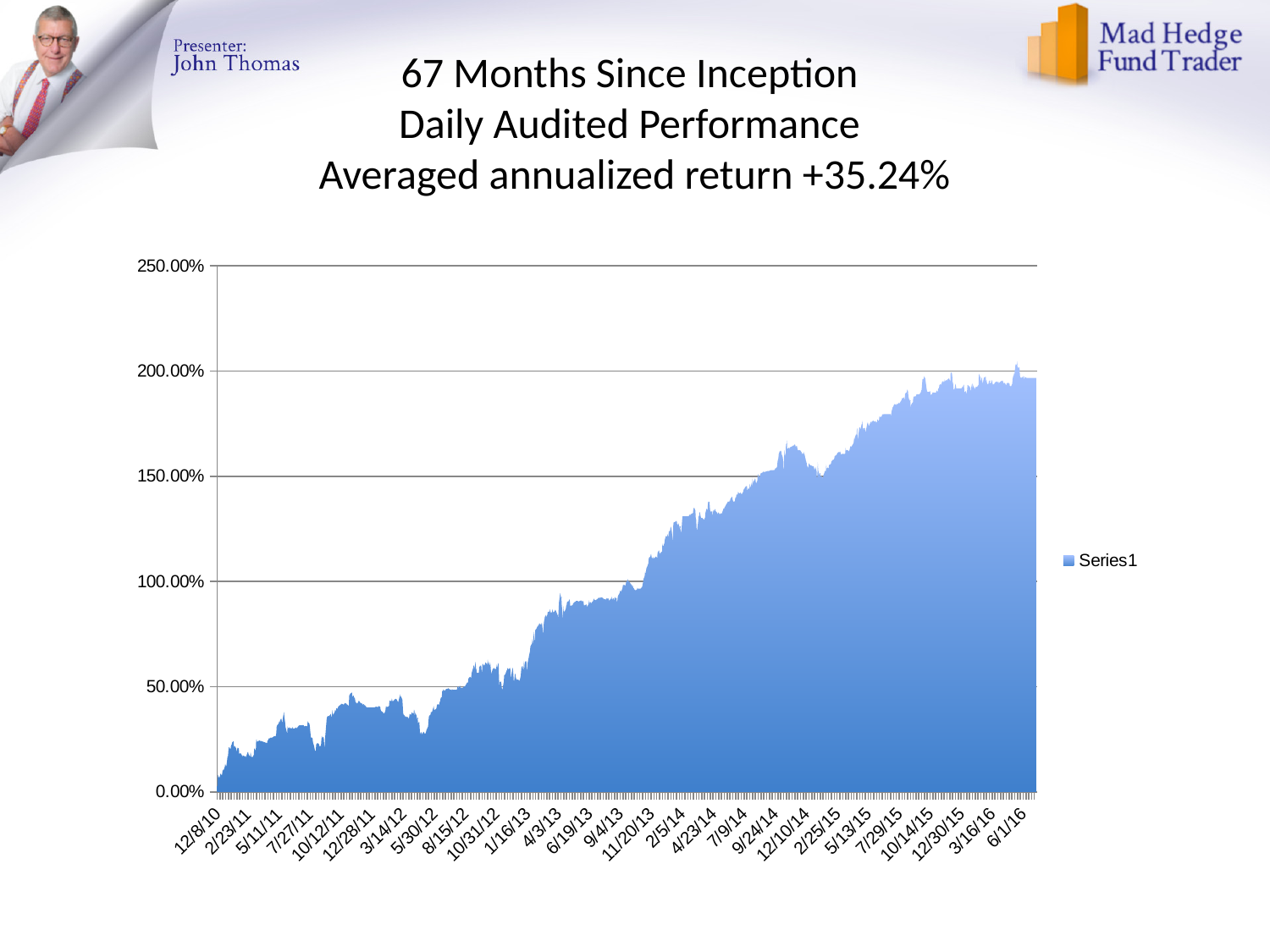
Is the value at 7/9/14 greater or less than 100.00%? greater Is the value at 12/8/10 greater or less than 50.00%? less Is the value at 6/1/16 greater or less than 150.00%? greater What is the name of the series shown in the legend? Series1 What kind of chart is shown on the slide? Area chart Do the values generally rise or fall from 12/8/10 to 6/1/16? Rise What averaged annualized return is stated in the chart title? +35.24% How many series does the legend list? 1